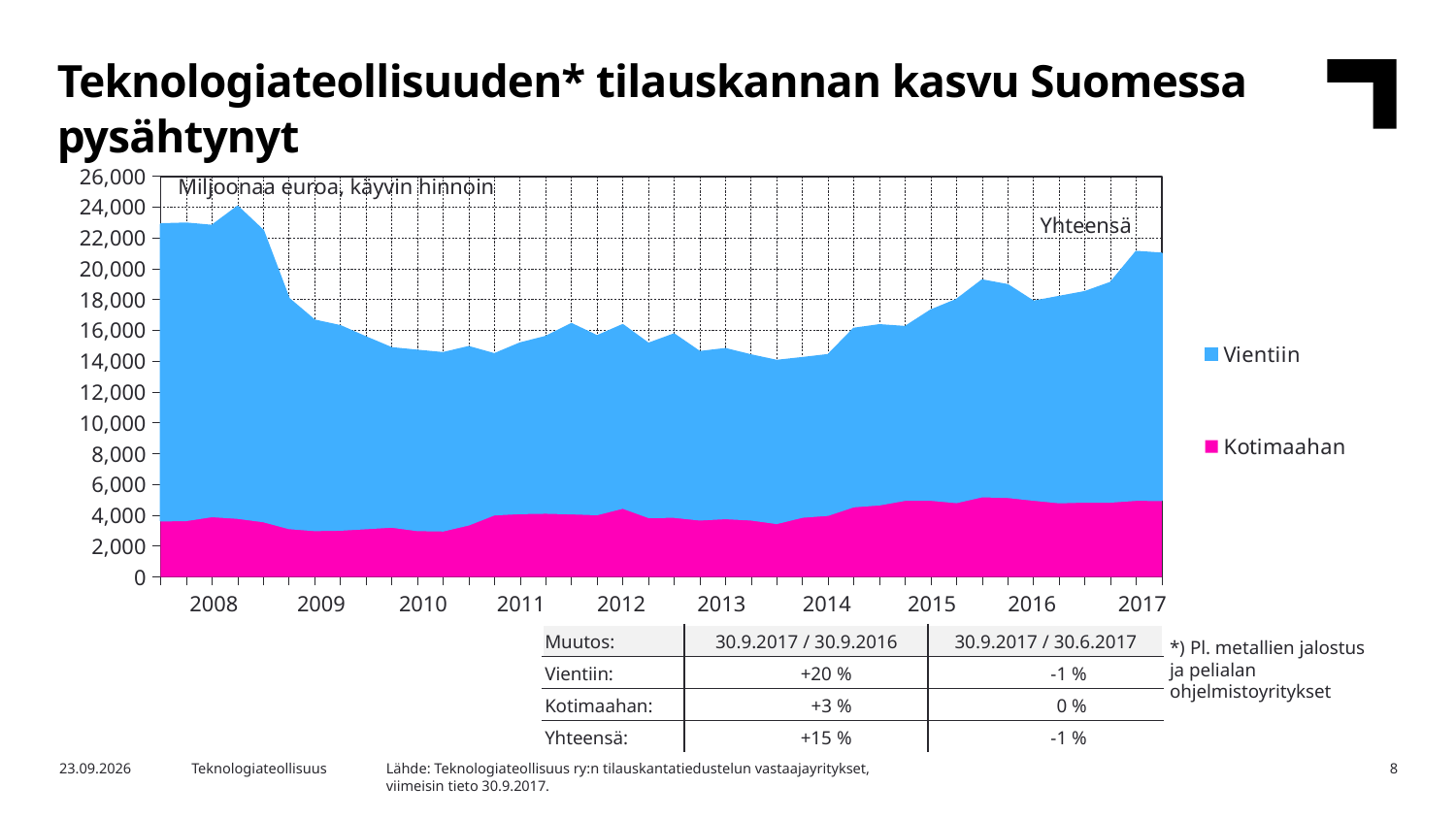
How many series does the chart legend list? 2 Does the total (Yhteensä) value rise or fall from 2008 to 2010? fall Which is larger, the total (Yhteensä) value in 2008 or in 2014? 2008 Is the total (Yhteensä) value at the start of 2008 greater or less than 20,000? greater Does the total (Yhteensä) value rise or fall from 2014 to 2017? rise What unit label is printed inside the chart area? Miljoonaa euroa, käyvin hinnoin What are the two series named in the chart legend? Vientiin and Kotimaahan How many year labels are shown on the x axis of the chart? 10 What kind of chart is shown on the slide? area chart Is the Kotimaahan value in 2010 greater or less than 4,000? less Is the Kotimaahan value at the end of 2017 greater or less than 6,000? less